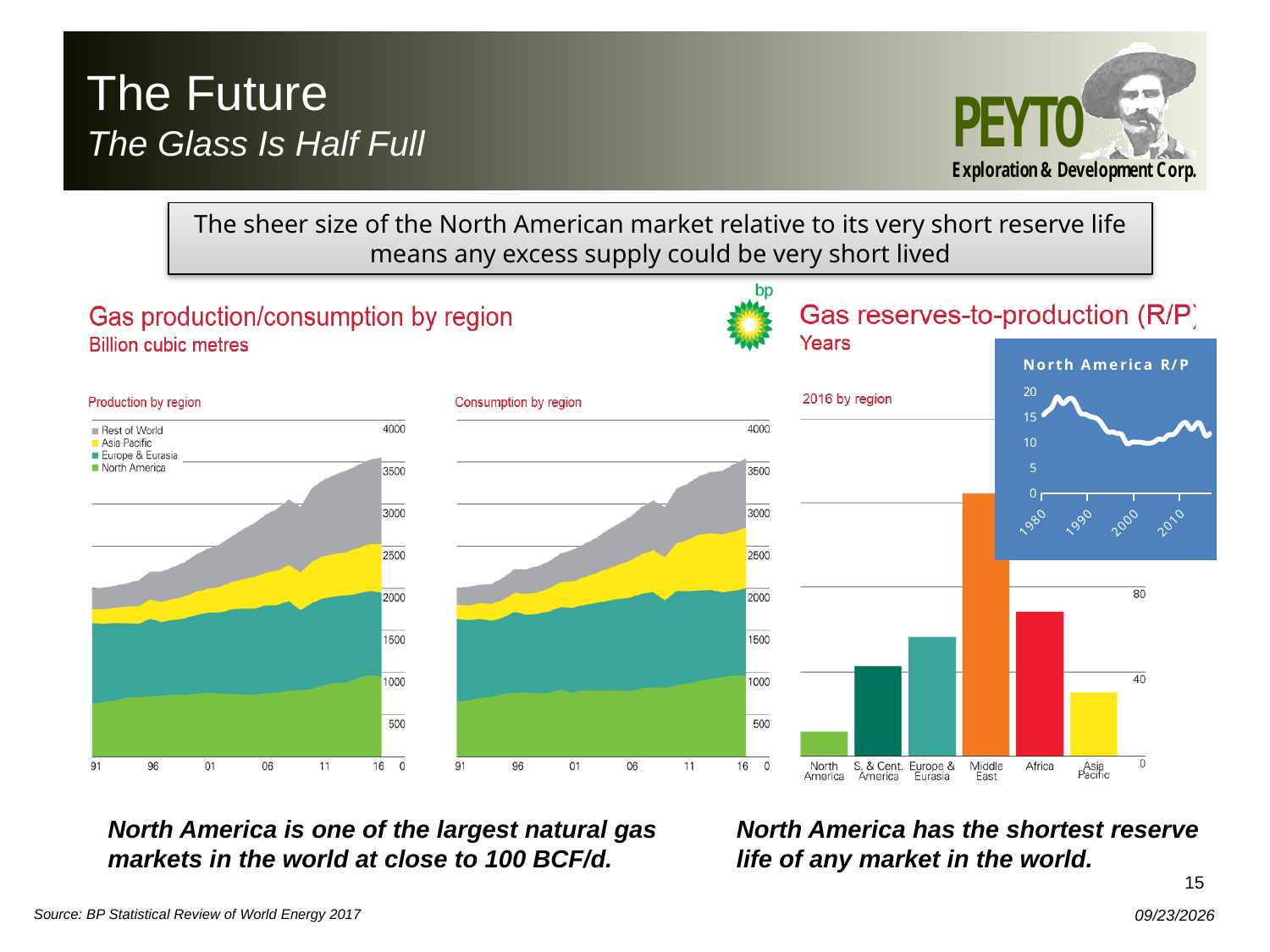
In the 'Production by region' chart, which colour represents North America? Green What kind of chart is the 'North America R/P' inset chart? Line chart What kind of chart is the 'Gas reserves-to-production (R/P)' 2016 by region chart? Bar chart How many series does the legend of the 'Production by region' chart list? 4 In the 'Gas reserves-to-production (R/P)' bar chart, which region has the highest value? Middle East In the 'Gas reserves-to-production (R/P)' bar chart, is the value for Europe & Eurasia greater or less than 40? greater In the 'Gas reserves-to-production (R/P)' bar chart, which region has the lowest value? North America In the 'Gas reserves-to-production (R/P)' bar chart, which is larger, Africa or Europe & Eurasia? Africa In the 'Production by region' chart, does total production rise or fall from 91 to 16? Rise In the 'Gas reserves-to-production (R/P)' bar chart, is the value for Middle East greater or less than 80? greater In the 'Gas reserves-to-production (R/P)' bar chart, how many regions are shown? 6 In the 'Gas reserves-to-production (R/P)' bar chart, is the value for North America greater or less than 40? less